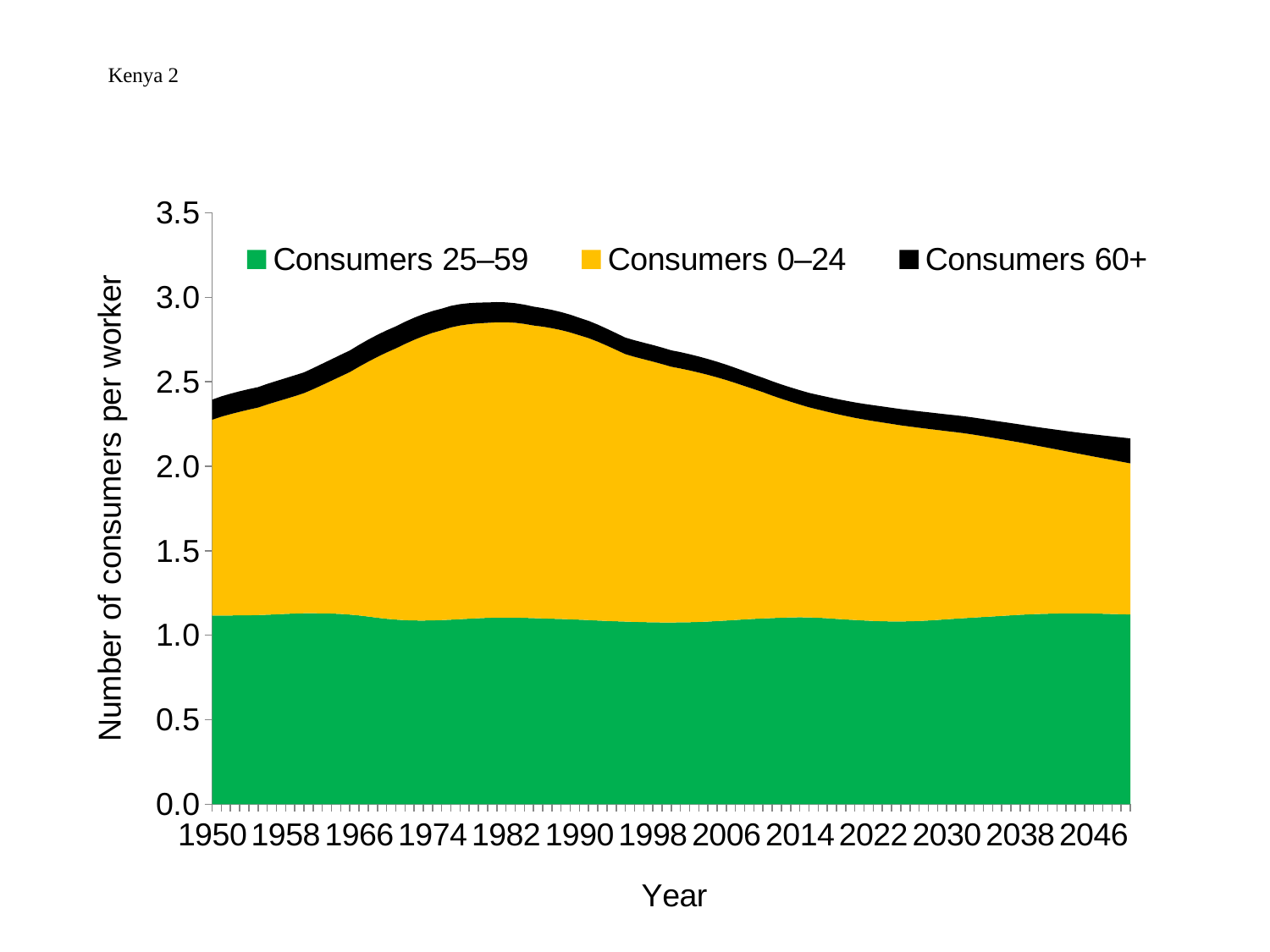
Is the total number of consumers per worker in 2046 greater or less than 2.5? less How many year labels are shown on the x axis? 13 Which series contributes the smallest number of consumers per worker across all years? Consumers 60+ Does the total number of consumers per worker rise or fall between 1950 and 1982? rise Does the total number of consumers per worker rise or fall between 1982 and 2046? fall In 1982, which is larger: the Consumers 0–24 band or the Consumers 25–59 band? Consumers 0–24 What kind of chart is shown on the slide? Stacked area chart How many series does the legend list? 3 Is the value for Consumers 25–59 in 1950 greater or less than 1.0? greater What is the label of the vertical axis? Number of consumers per worker Which series does the legend list in black? Consumers 60+ Is the total number of consumers per worker in 1982 greater or less than 2.5? greater